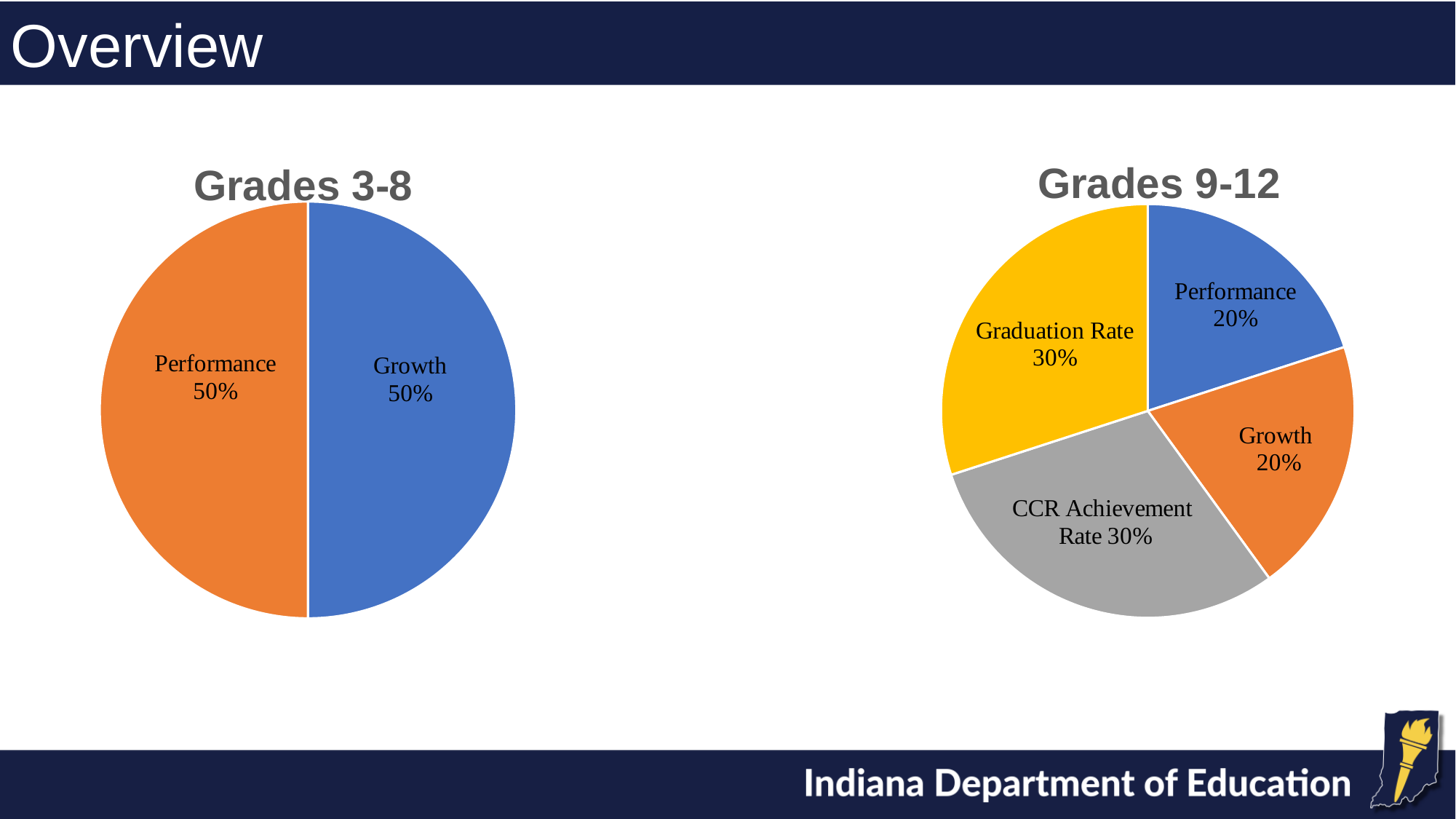
What kind of chart is the Grades 9-12 chart? Pie chart In the Grades 3-8 chart, what share does Performance have? 50% In the Grades 9-12 chart, what share does CCR Achievement Rate have? 30% In the Grades 9-12 chart, which is larger, Performance or CCR Achievement Rate? CCR Achievement Rate In the Grades 3-8 chart, how many slices are there? 2 In the Grades 9-12 chart, what colour is the Graduation Rate slice? Yellow In the Grades 9-12 chart, what share does Performance have? 20% In the Grades 9-12 chart, what share does Growth have? 20% In the Grades 9-12 chart, how many slices are there? 4 In the Grades 9-12 chart, what share does Graduation Rate have? 30% In the Grades 3-8 chart, what share does Growth have? 50% In the Grades 9-12 chart, what is the difference between the Graduation Rate share and the Growth share? 10%